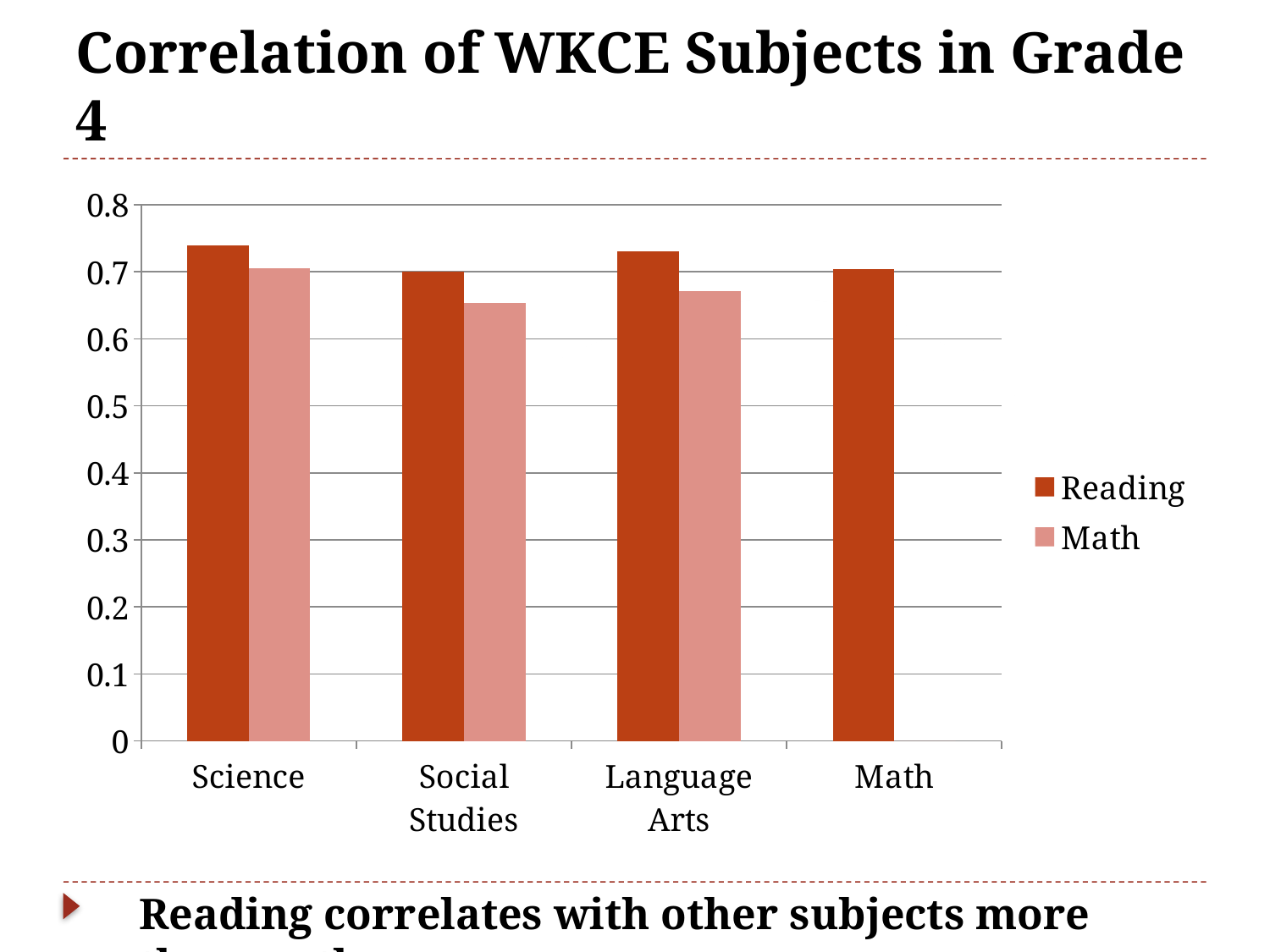
Is the Reading value for Language Arts greater or less than 0.7? greater What kind of chart is shown on the slide? bar chart Is the Math value for Social Studies greater or less than 0.7? less Is the Reading value for Science greater or less than 0.7? greater How many series does the legend list? 2 For Science, which series has the larger value, Reading or Math? Reading For Social Studies, which series has the larger value, Reading or Math? Reading What is the title of the chart? Correlation of WKCE Subjects in Grade 4 How many subject categories are shown on the x axis? 4 Which series is shown in the darker red bars? Reading